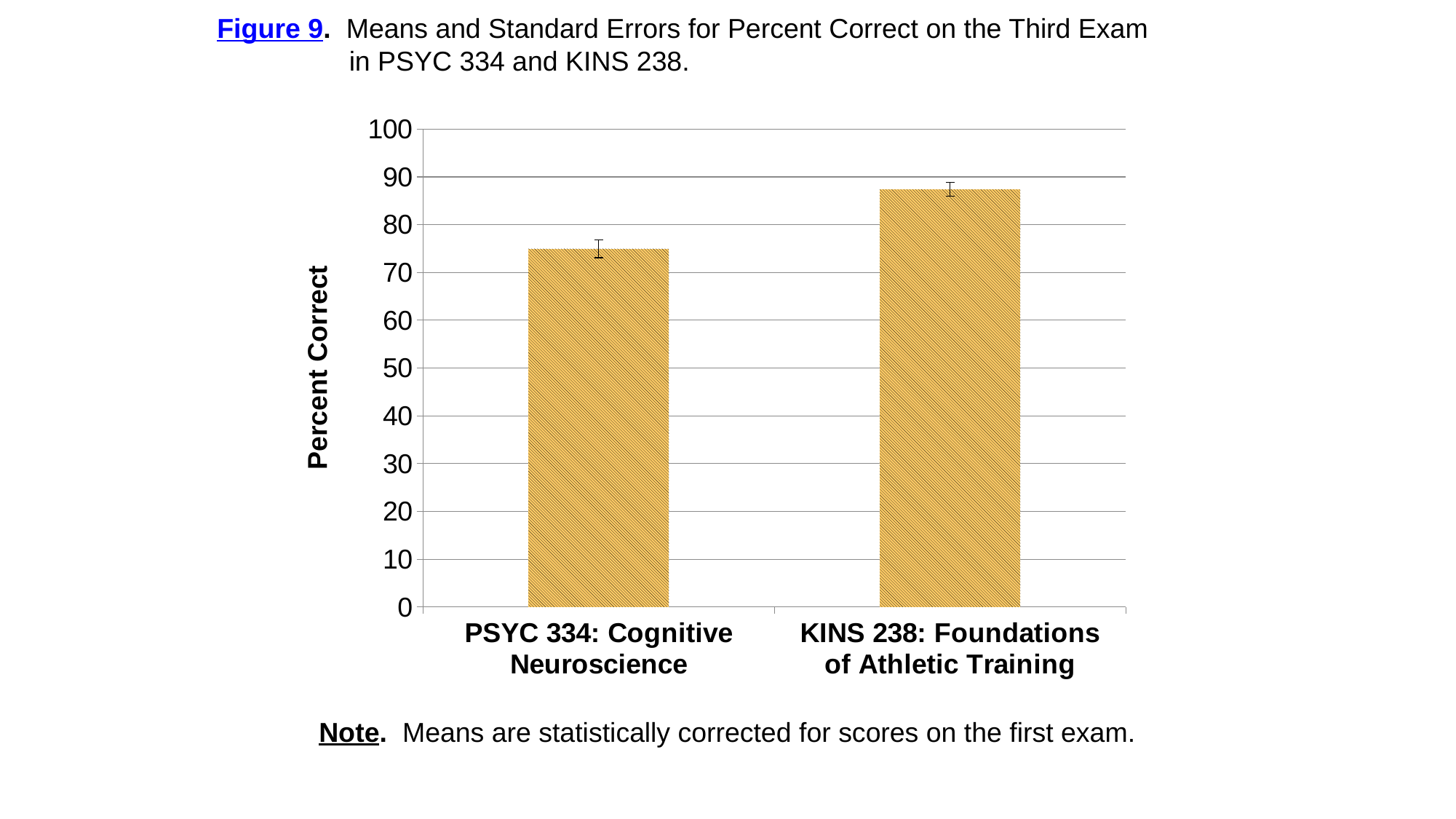
Is the percent correct for KINS 238: Foundations of Athletic Training greater or less than 80? greater Is the percent correct for PSYC 334: Cognitive Neuroscience greater or less than 80? less What kind of chart is shown on the slide? bar chart Which category has the highest percent correct? KINS 238: Foundations of Athletic Training What is the label of the y axis? Percent Correct Which is larger, the percent correct for PSYC 334: Cognitive Neuroscience or for KINS 238: Foundations of Athletic Training? KINS 238: Foundations of Athletic Training What is the maximum value shown on the y axis? 100 Is the percent correct for PSYC 334: Cognitive Neuroscience greater or less than 70? greater Which category has the lowest percent correct? PSYC 334: Cognitive Neuroscience How many categories are plotted on the x axis? 2